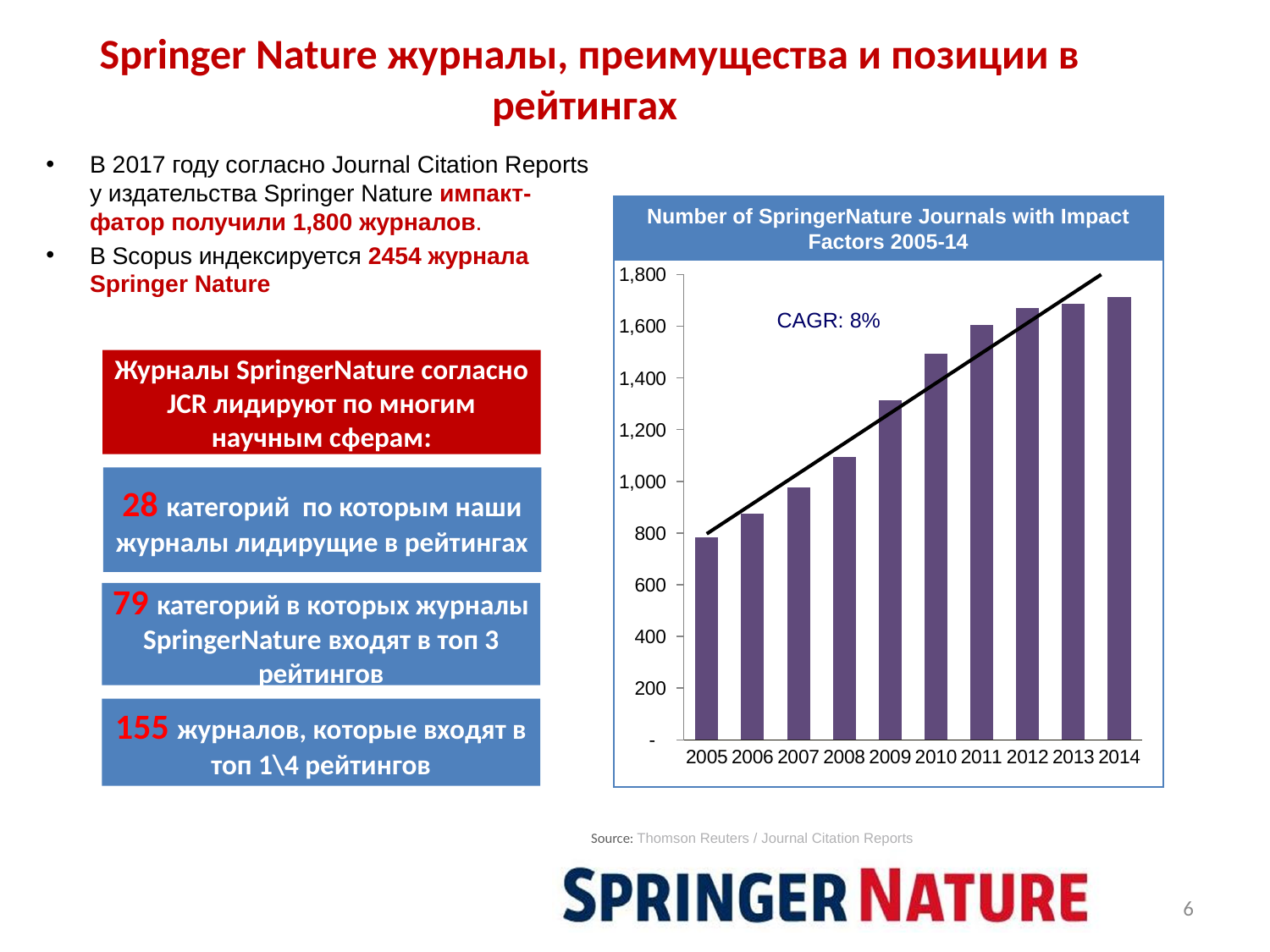
What kind of chart is shown on the slide? bar chart Which year has the larger value, 2006 or 2012? 2012 What is the title of the chart? Number of SpringerNature Journals with Impact Factors 2005-14 Which year has the lowest number of SpringerNature journals with impact factors? 2005 Do the values rise or fall from 2005 to 2014? rise How many years are plotted on the x axis of the chart? 10 Is the value for 2014 greater or less than 1,800? less Is the value for 2010 greater or less than 1,400? greater Which year has the highest number of SpringerNature journals with impact factors? 2014 Is the value for 2005 greater or less than 600? greater What CAGR is annotated on the chart? 8%